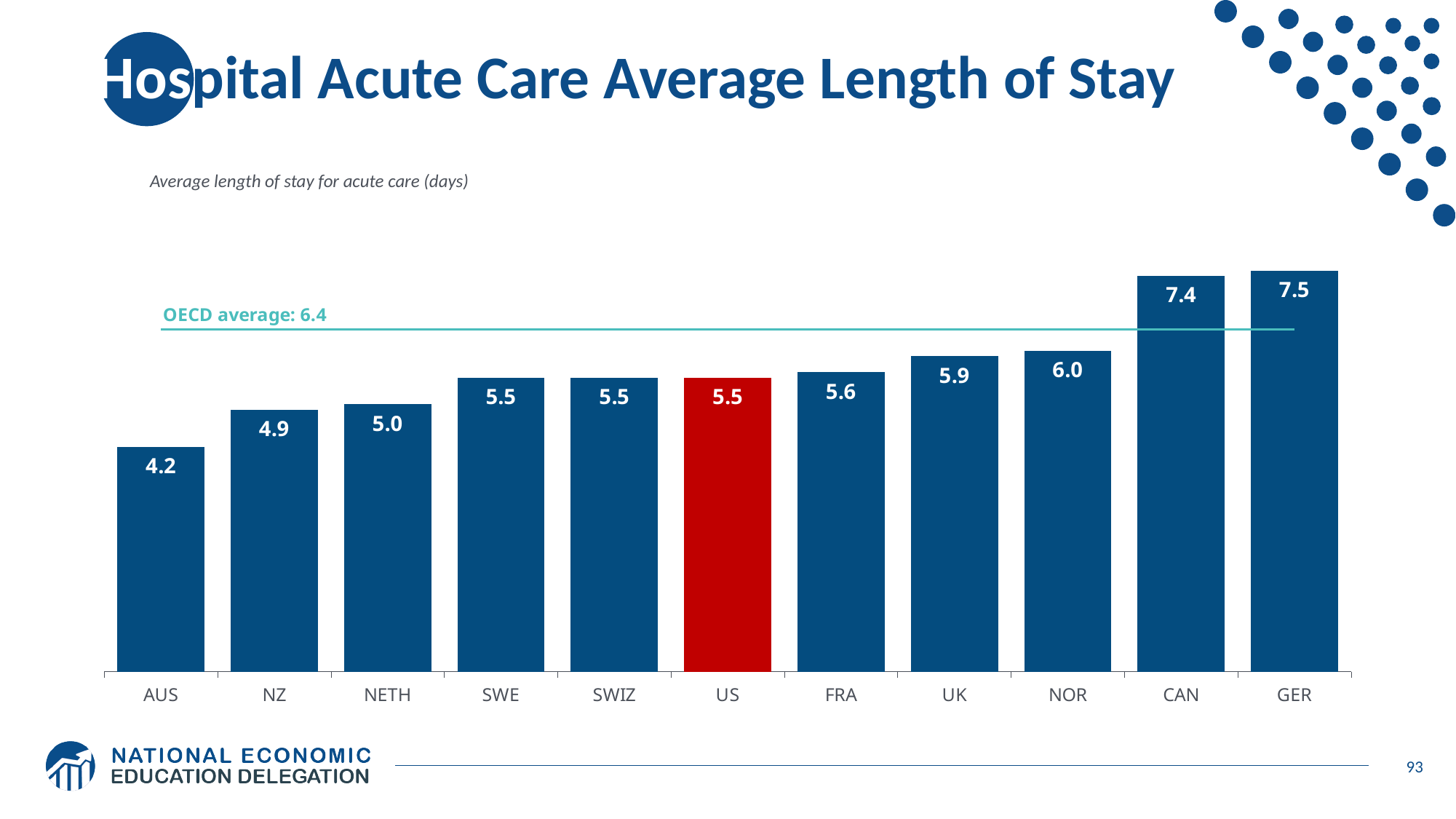
What OECD average value is marked by the horizontal line on the chart? 6.4 What type of chart is shown on the slide? Bar chart Which country has the lowest average length of stay for acute care? AUS What is the value shown for AUS? 4.2 What is the average length of stay for acute care in Germany (GER)? 7.5 How many countries are shown in the chart? 11 Which country has the highest average length of stay for acute care? GER What is the difference between the values for NOR and NZ? 1.1 Which has a higher average length of stay, UK or FRA? UK What is the difference between the values for CAN and AUS? 3.2 Do the values generally rise or fall from left to right across the countries? Rise What is the average length of stay for acute care in the US? 5.5